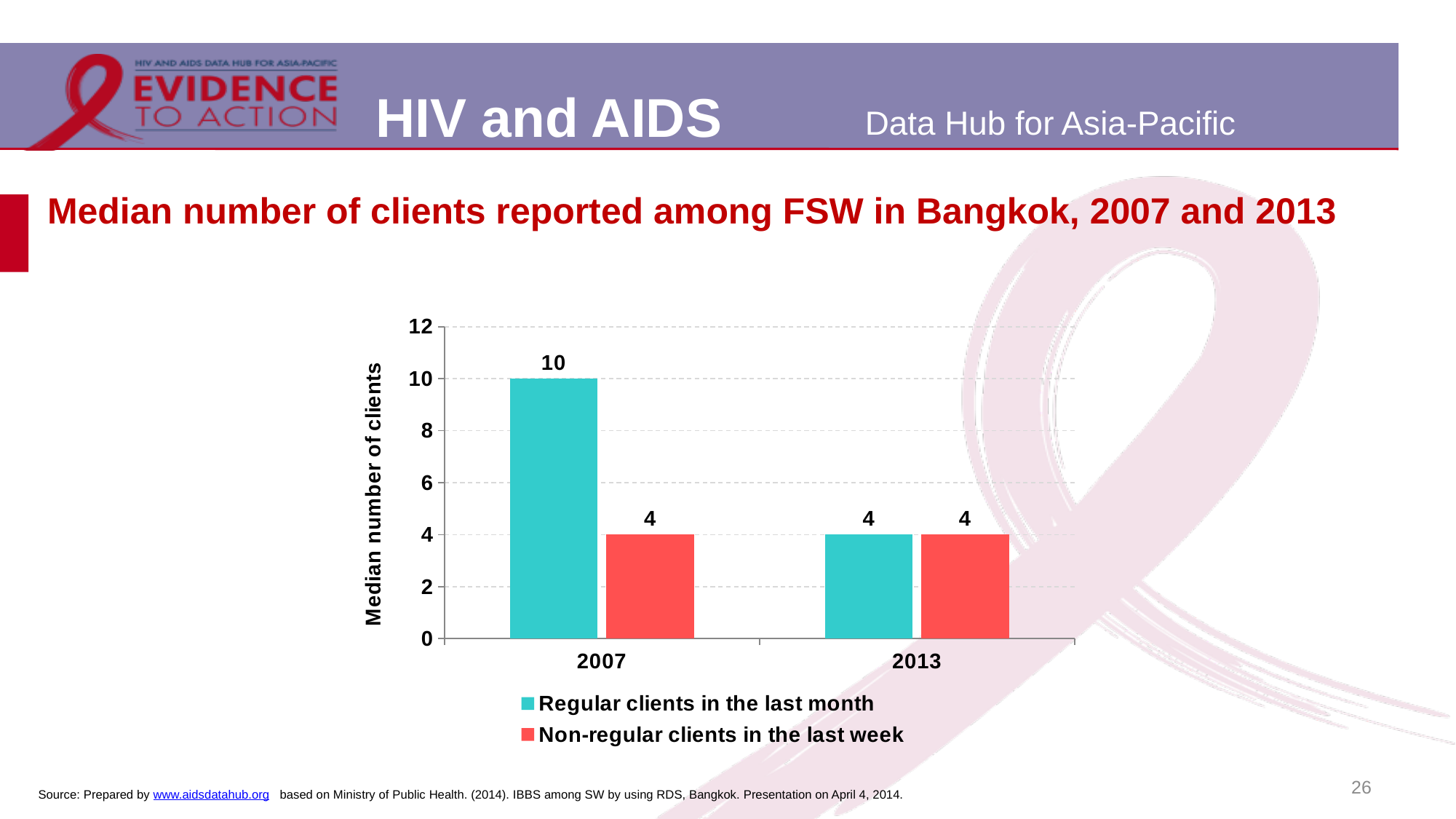
How many series does the legend list? 2 Did the median number of regular clients in the last month rise or fall from 2007 to 2013? Fall In 2007, which is larger: regular clients in the last month or non-regular clients in the last week? Regular clients in the last month What is the median number of non-regular clients in the last week in 2007? 4 What is the median number of regular clients in the last month reported among FSW in Bangkok in 2007? 10 How many years are shown on the x axis? 2 Which bar shows the highest median number of clients? Regular clients in the last month, 2007 In 2007, what is the difference between the median number of regular clients in the last month and non-regular clients in the last week? 6 What type of chart is shown on the slide? Bar chart By how much did the median number of regular clients in the last month fall from 2007 to 2013? 6 What is the median number of non-regular clients in the last week in 2013? 4 What is the median number of regular clients in the last month in 2013? 4